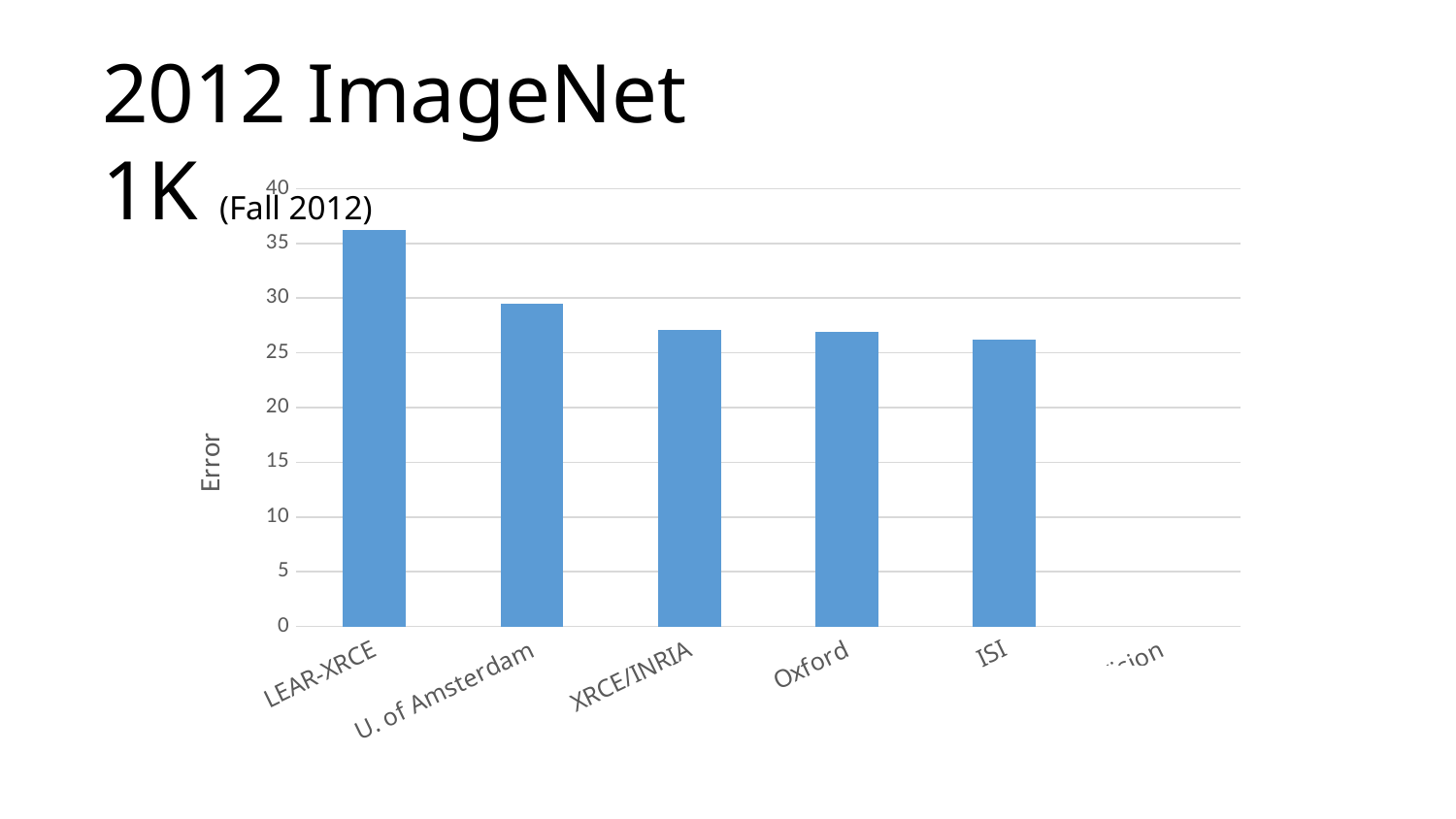
What is the label on the vertical axis of the chart? Error Is the value for U. of Amsterdam greater or less than 30? less What kind of chart is shown on the slide? bar chart Which is larger, the value for U. of Amsterdam or the value for ISI? U. of Amsterdam What colour are the bars in the chart? blue Which is larger, the value for LEAR-XRCE or the value for U. of Amsterdam? LEAR-XRCE Is the value for Oxford greater or less than 30? less Do the bar values rise or fall from left to right across the chart? fall Is the value for XRCE/INRIA greater or less than 25? greater Which category has the highest error value? LEAR-XRCE